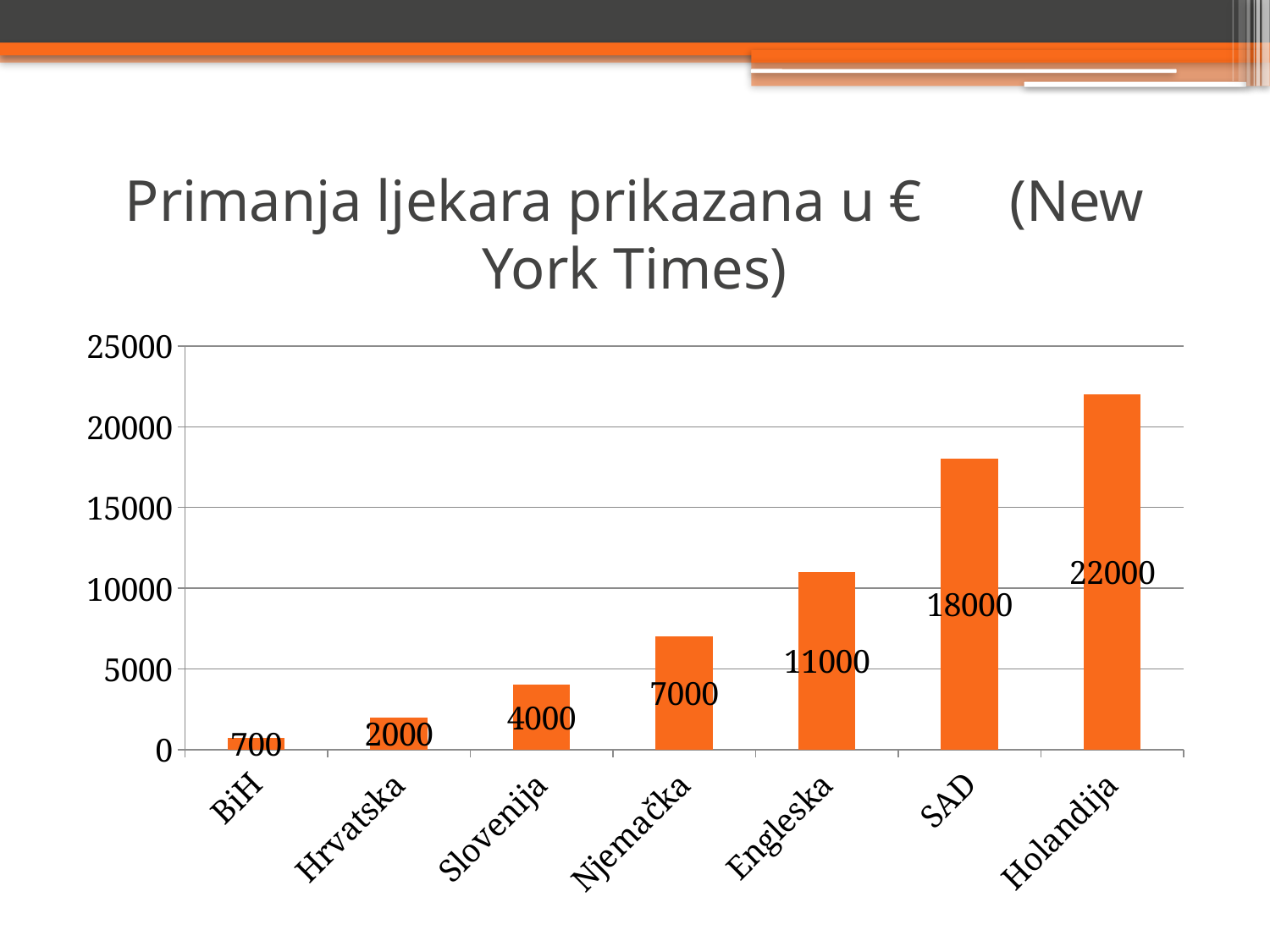
What is the value for BiH? 700 What kind of chart is shown on the slide? bar chart What is the value for SAD? 18000 How many categories are shown on the x axis? 7 Is the value for Engleska greater or less than 10000? greater What is the value for Njemačka? 7000 Which category has the lowest value? BiH What is the difference between the values for Holandija and SAD? 4000 What is the difference between the values for Engleska and Slovenija? 7000 Do the values rise or fall from left to right along the x axis? rise Which is larger, the value for Hrvatska or the value for Slovenija? Slovenija Which category has the highest value? Holandija